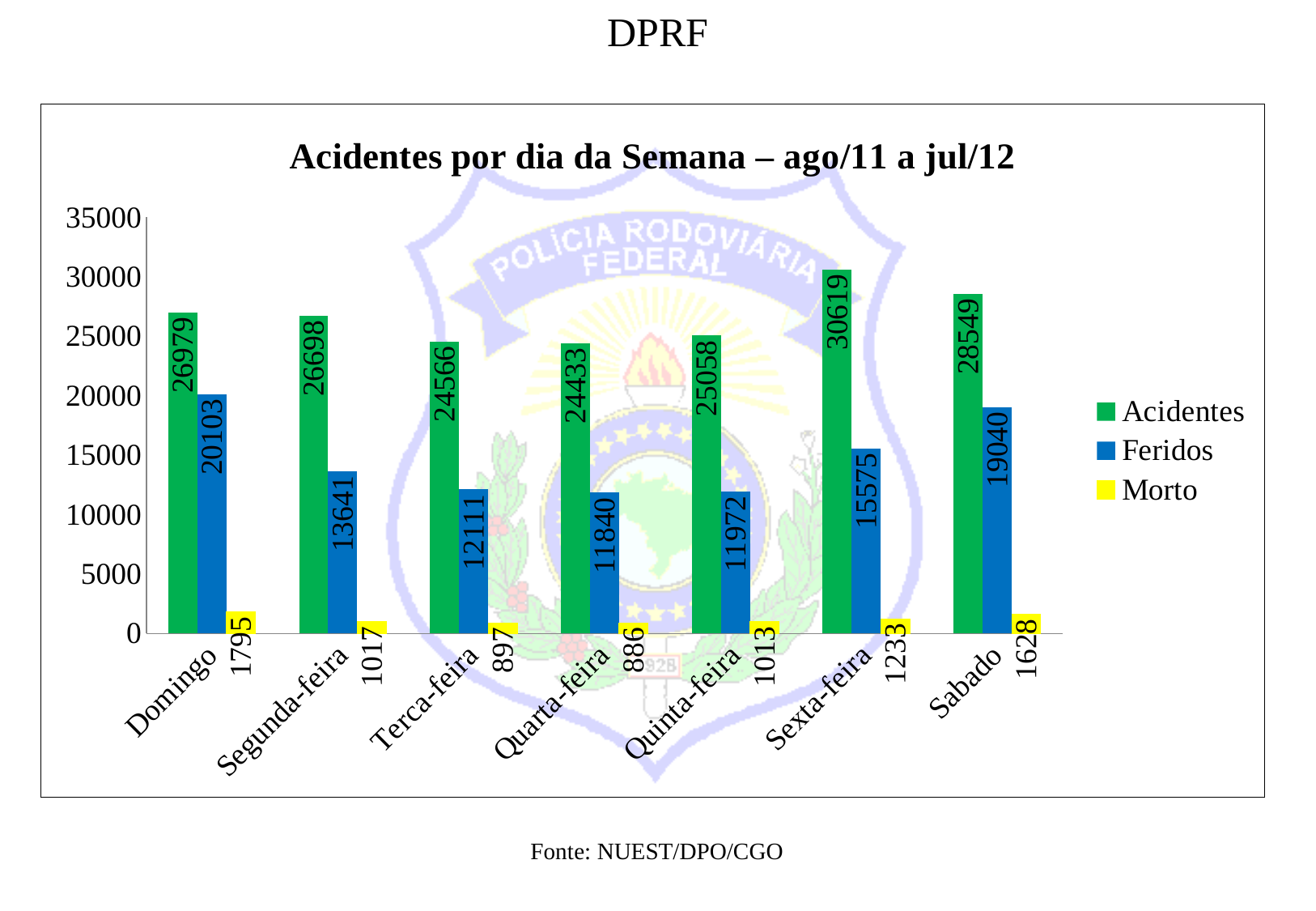
Which is larger, Feridos for Segunda-feira or Feridos for Sexta-feira? Sexta-feira What is the title of the chart? Acidentes por dia da Semana – ago/11 a jul/12 Which day has the highest number of Acidentes? Sexta-feira What is the value of Morto for Quarta-feira? 886 How many days of the week are shown on the x axis? 7 How many series does the legend list? 3 Which day has the highest number of Morto? Domingo What is the value of Feridos for Domingo? 20103 What is the difference in Acidentes between Sexta-feira and Sabado? 2070 What is the value of Acidentes for Sexta-feira? 30619 Which day has the lowest number of Feridos? Quarta-feira What type of chart is shown? Bar chart